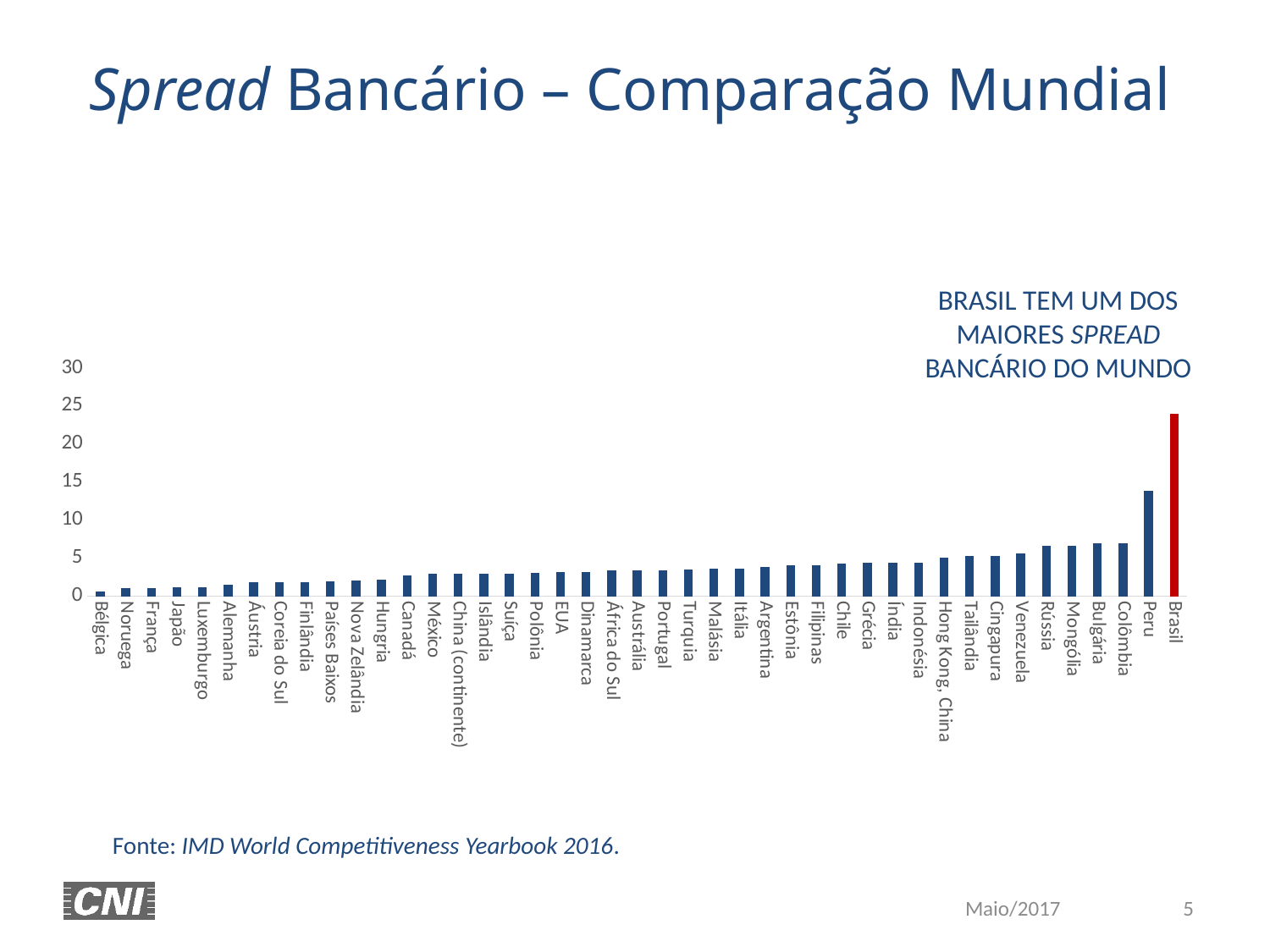
Is the value for Rússia greater or less than 10? less Is the value for Peru greater or less than 15? less Which country has the lowest bank spread in the chart? Bélgica Which country has the highest bank spread in the chart? Brasil Which has a larger bank spread, Brasil or Peru? Brasil What kind of chart is shown on the slide? Bar chart Is the value for Peru greater or less than 10? greater Do the values rise or fall from left to right along the x axis? Rise How many countries are shown in the chart? 43 Which has a larger bank spread, Colômbia or Japão? Colômbia What colour is the bar for Brasil? Red